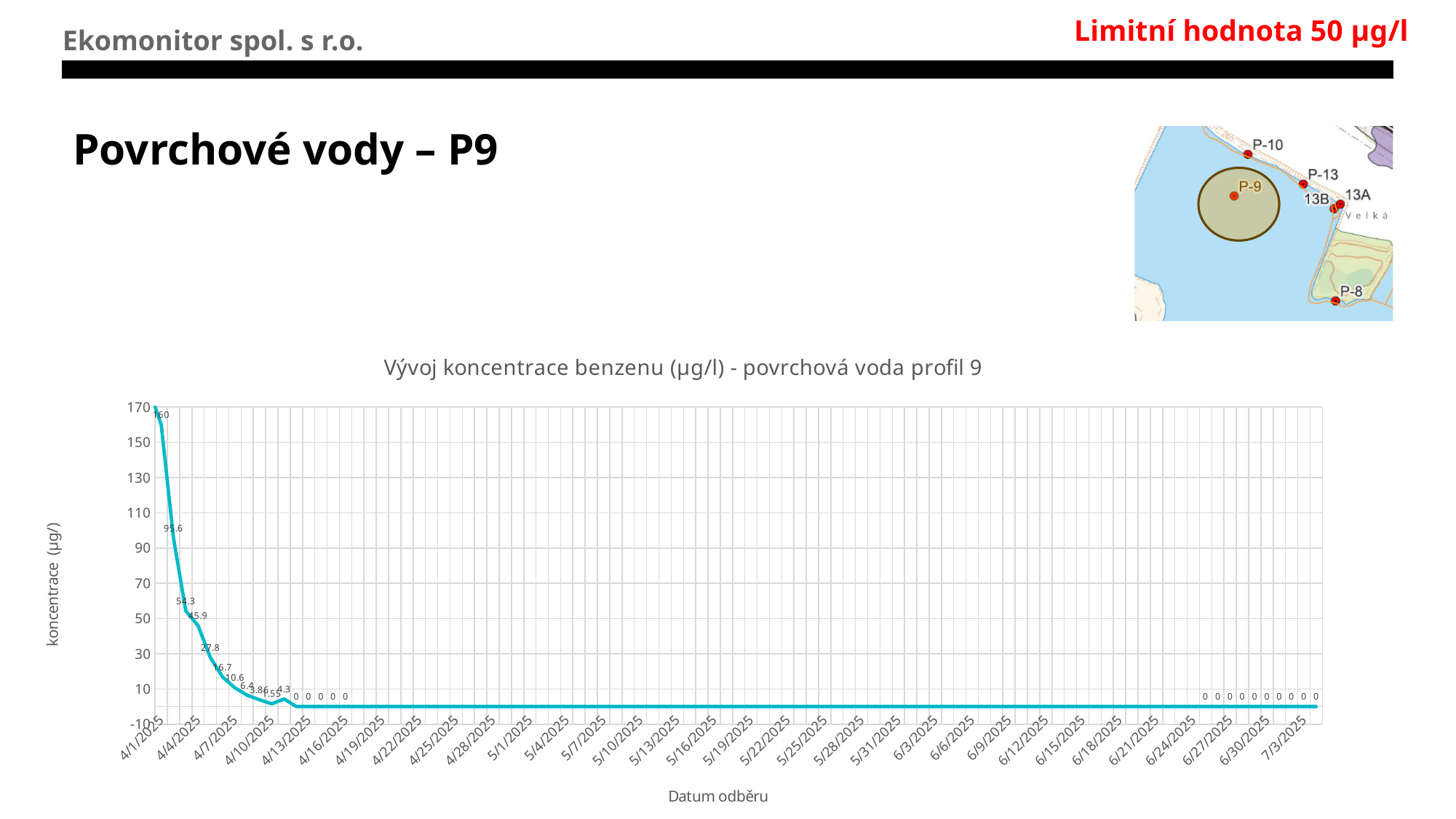
What is the value plotted for 7/3/2025? 0 Which date has the larger value, 4/1/2025 or 7/3/2025? 4/1/2025 On which date does the chart reach its highest value? 4/1/2025 Do the values rise or fall along the x axis from 4/1/2025 onward? fall What kind of chart is shown on the slide? line chart What is the difference between the first plotted value (160) and the second plotted value (95.6)? 64.4 What is the lowest value plotted on the chart? 0 What is the label of the vertical axis of the chart? koncentrace (µg/l) What is the highest value plotted on the chart? 160 What is the title of the chart? Vývoj koncentrace benzenu (µg/l) - povrchová voda profil 9 What is the benzene concentration value plotted for 4/1/2025? 160